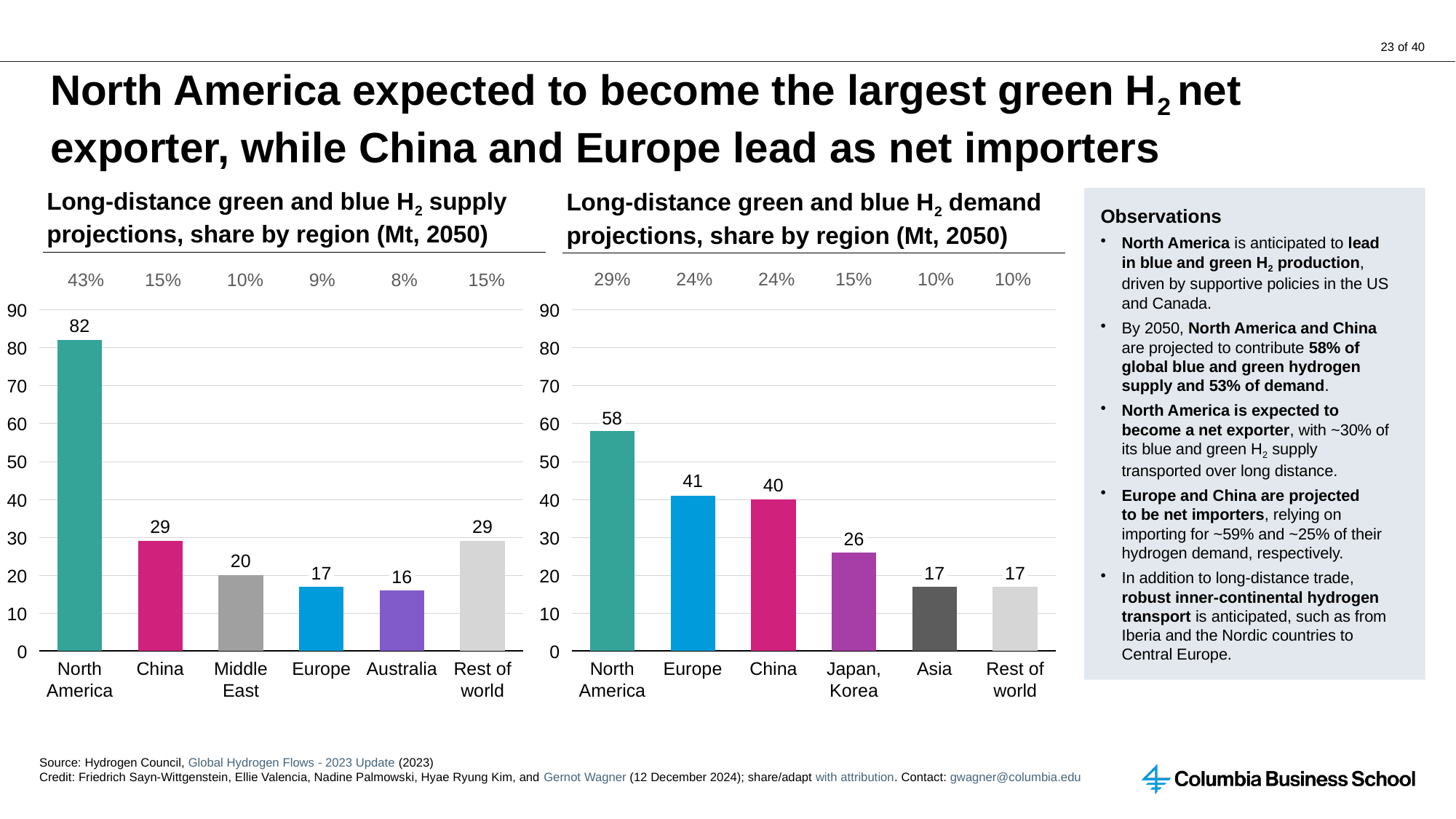
What kind of chart is the supply projections chart (left)? bar chart In the supply projections chart (left), which region has the lowest value? Australia In the demand projections chart (right), what is the value for Europe? 41 In the demand projections chart (right), what percentage share is shown above the Europe bar? 24% In the demand projections chart (right), what is the difference between the values for North America and China? 18 How many regions are shown in the demand projections chart (right)? 6 In the supply projections chart (left), what percentage share is shown above the North America bar? 43% In the supply projections chart (left), what is the value for North America? 82 In the supply projections chart (left), which is larger, the value for Middle East or the value for Europe? Middle East In the demand projections chart (right), is the value for Japan, Korea greater or less than 20? greater In the supply projections chart (left), what is the difference between the values for China and Australia? 13 In the supply projections chart (left), which region has the highest value? North America